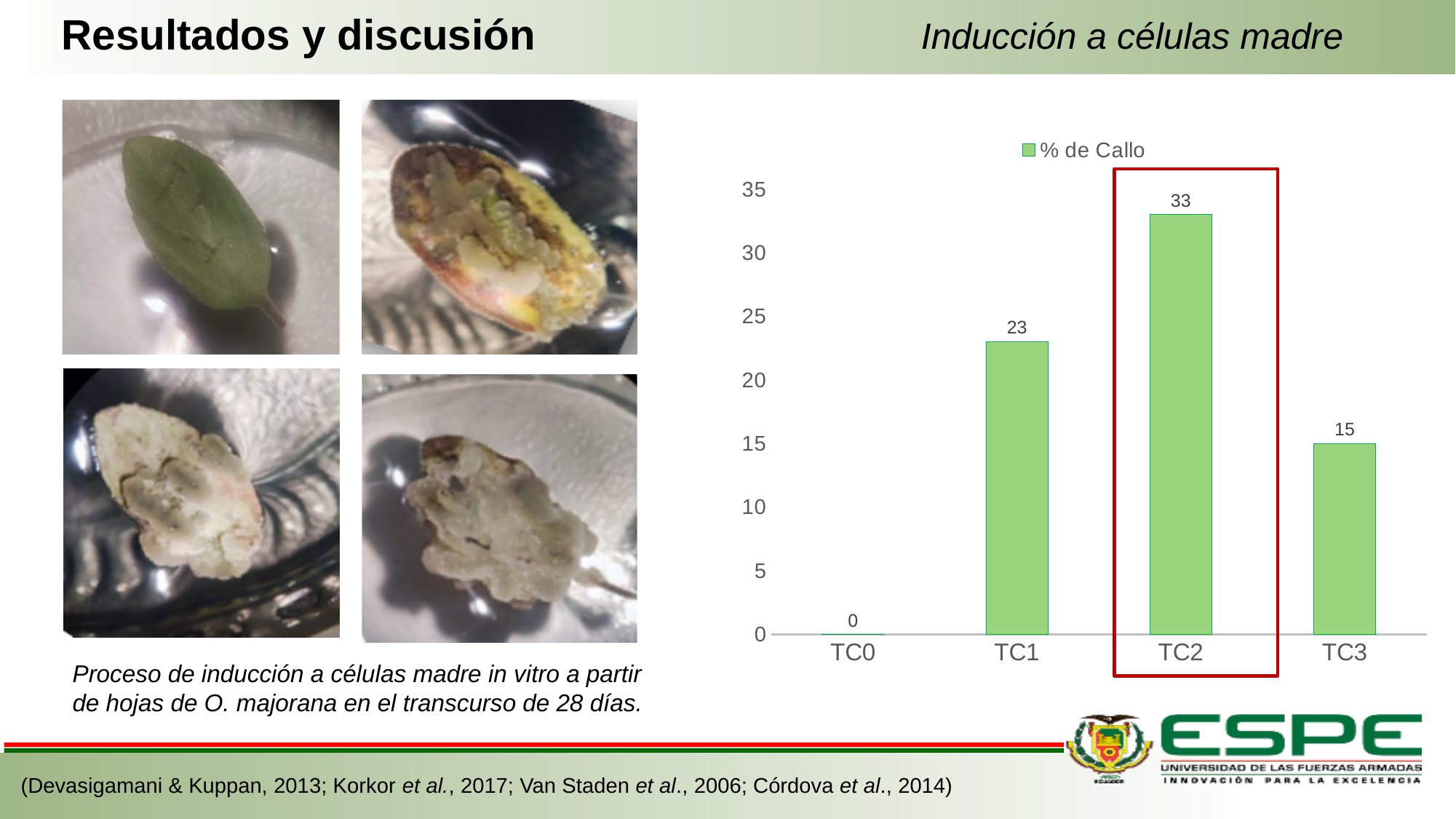
What is the % de Callo value for TC3? 15 How many categories are shown on the x axis of the chart? 4 Which has a higher % de Callo, TC1 or TC3? TC1 What is the % de Callo value for TC2? 33 What is the difference in % de Callo between TC2 and TC1? 10 What is the % de Callo value for TC1? 23 What is the % de Callo value for TC0? 0 What kind of chart is shown on the slide? Bar chart Which category has the highest % de Callo? TC2 What series name is shown in the chart legend? % de Callo What is the difference in % de Callo between TC1 and TC3? 8 Which category has the lowest % de Callo? TC0